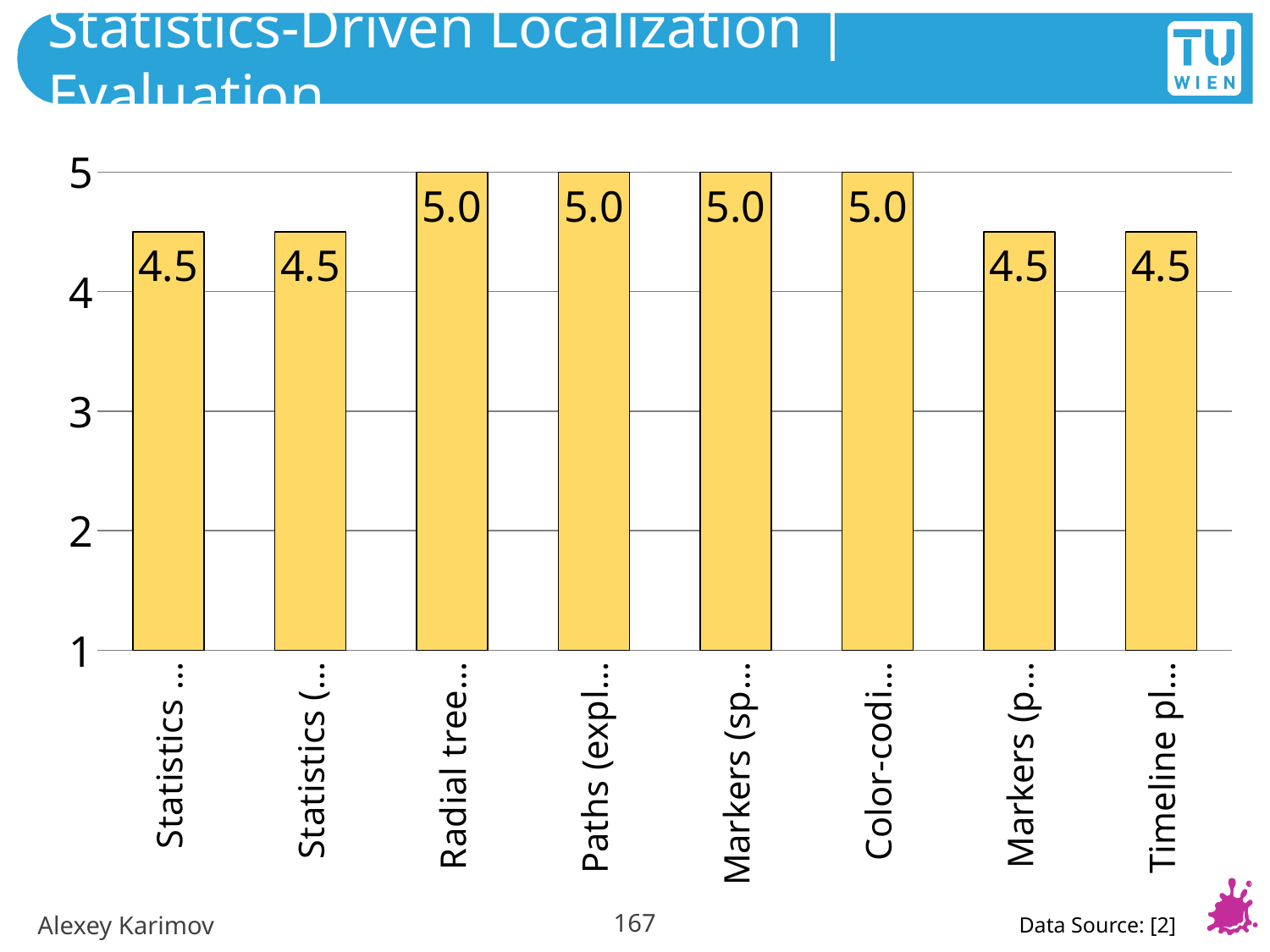
What is the value of the bar labelled "Radial tree..."? 5.0 What is the difference between the value of the "Radial tree..." bar and the "Timeline pl..." bar? 0.5 What is the value of the bar labelled "Color-codi..."? 5.0 What is the highest value shown by any bar in the chart? 5.0 Is the value for the bar labelled "Paths (expl..." greater or less than 4? greater How many bars in the chart have a value of 5.0? 4 What kind of chart is shown on the slide? bar chart What is the value of the leftmost bar in the chart? 4.5 Which bar has the larger value: "Radial tree..." or "Timeline pl..."? Radial tree... What is the value of the rightmost bar, labelled "Timeline pl..."? 4.5 What is the lowest value shown by any bar in the chart? 4.5 How many bars are plotted in the chart? 8